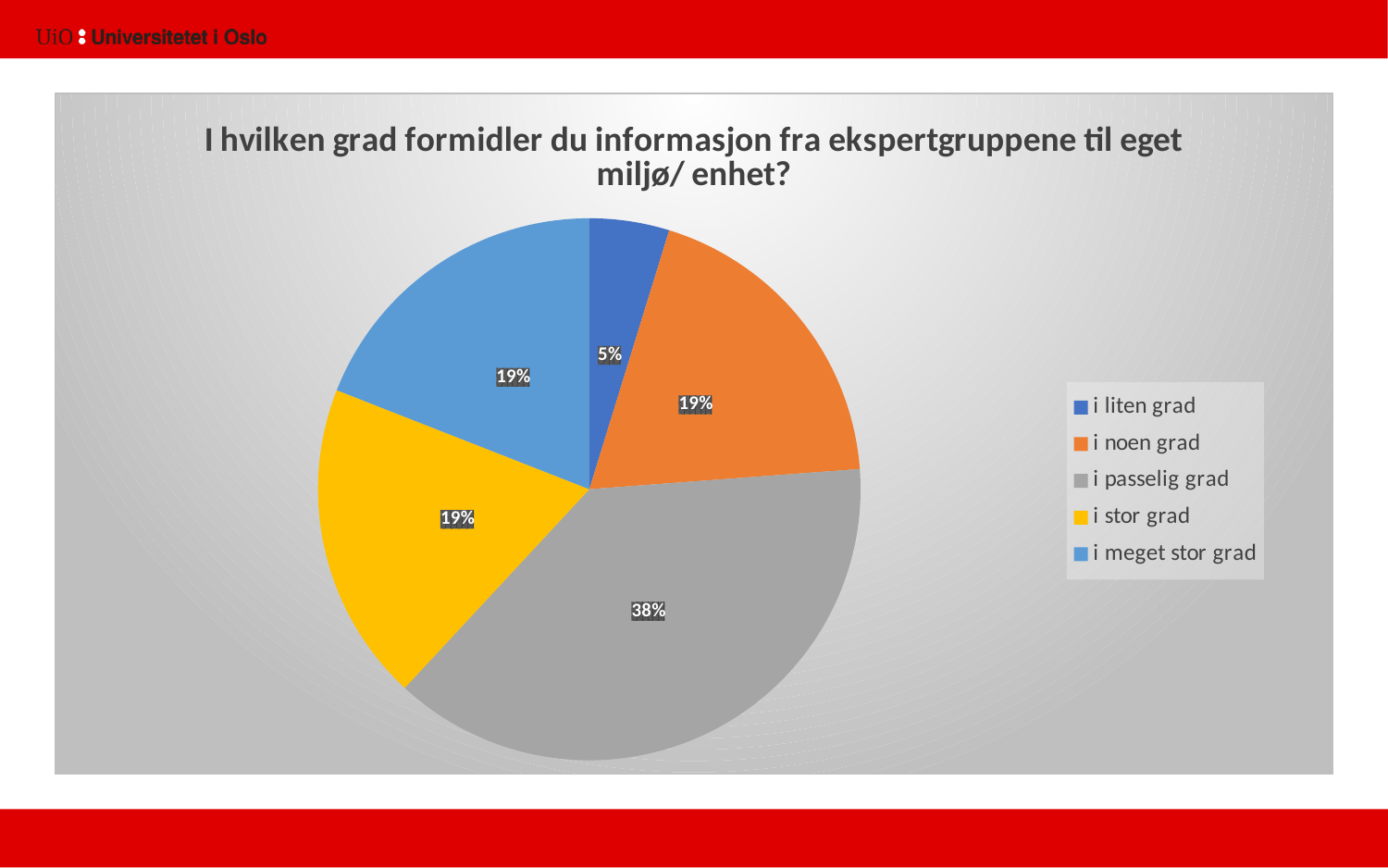
Which category has the largest slice of the pie? i passelig grad What is the value shown for "i liten grad"? 5% Which is larger, the slice for "i passelig grad" or the slice for "i stor grad"? i passelig grad What kind of chart is shown on the slide? pie chart What is the title of the chart? I hvilken grad formidler du informasjon fra ekspertgruppene til eget miljø/ enhet? Which category has the smallest slice of the pie? i liten grad How many categories does the pie chart have? 5 What is the value shown for "i noen grad"? 19% Which colour represents "i stor grad" in the legend? yellow What share of the pie does "i passelig grad" take? 38% What is the difference in percentage points between "i passelig grad" and "i liten grad"? 33 percentage points What is the value shown for "i meget stor grad"? 19%